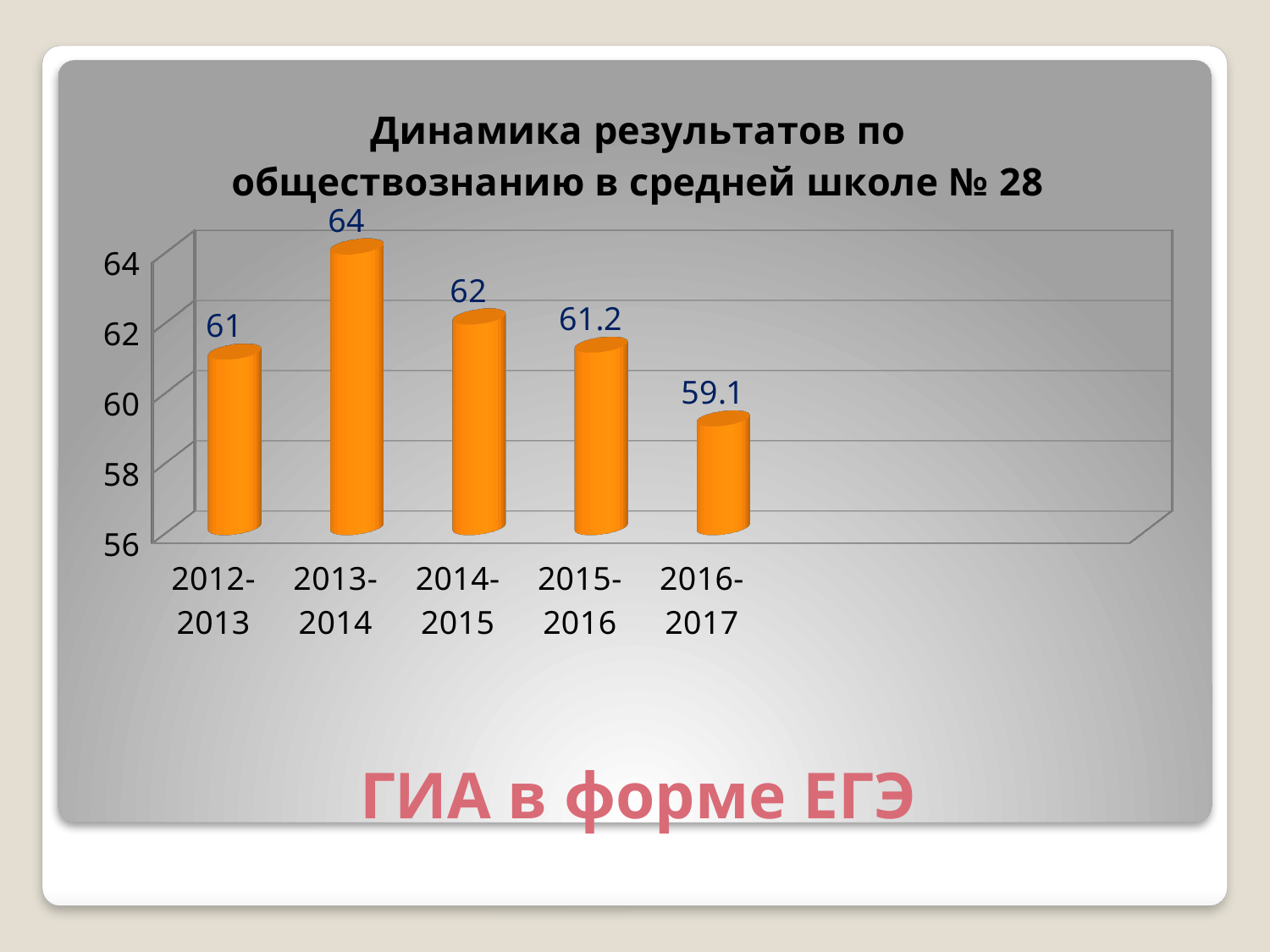
What is the value for 2012-2013? 61 What is the value for 2015-2016? 61.2 What is the difference between the values for 2013-2014 and 2016-2017? 4.9 Do the values rise or fall from 2013-2014 to 2016-2017? fall Which is larger, the value for 2014-2015 or the value for 2016-2017? 2014-2015 Which year has the highest value? 2013-2014 Which year has the lowest value? 2016-2017 What kind of chart is this? bar chart What is the value for 2016-2017? 59.1 What is the difference between the values for 2014-2015 and 2015-2016? 0.8 How many years are shown on the chart? 5 What is the value for 2013-2014? 64